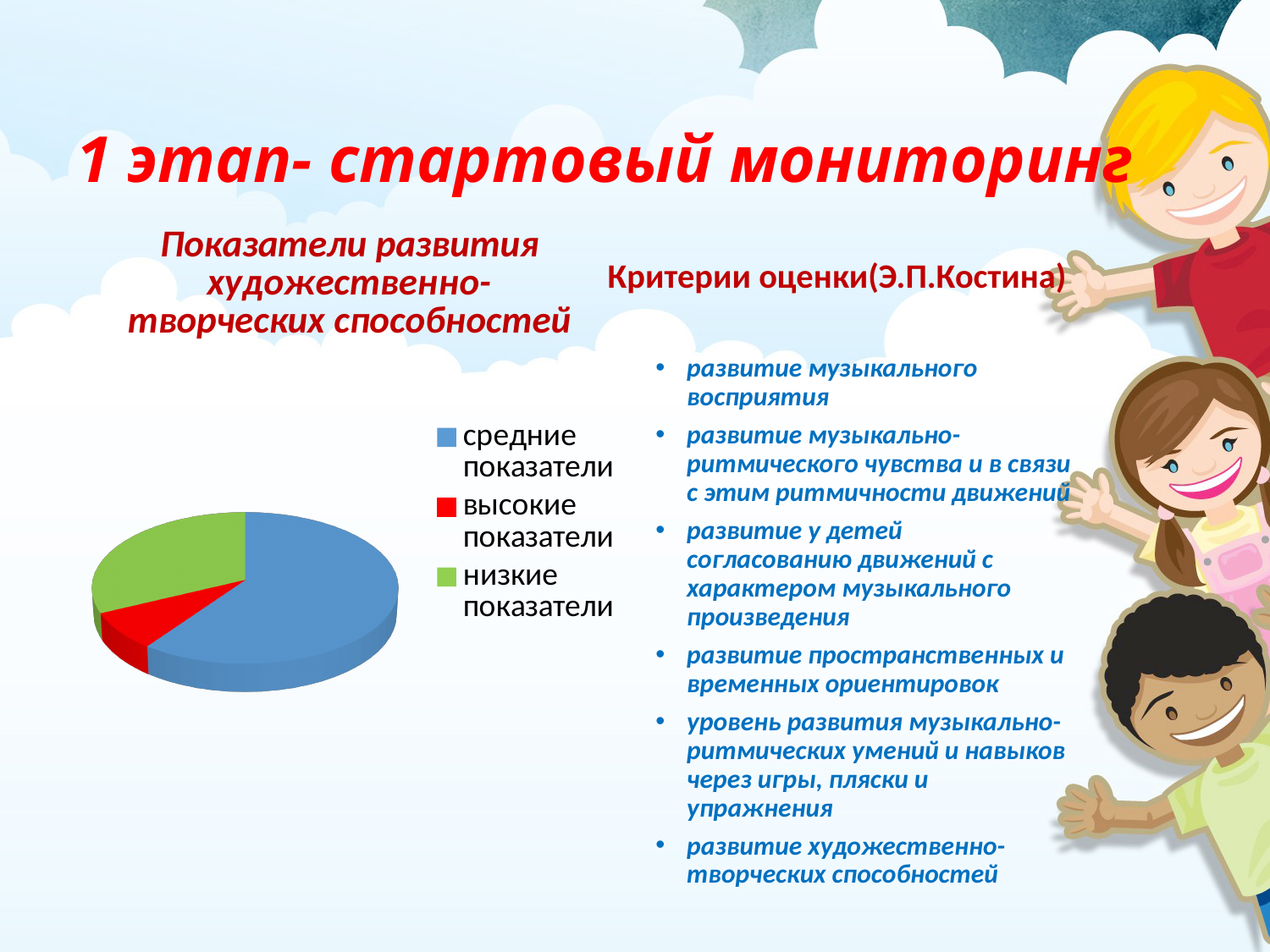
Which slice is larger in the pie chart: низкие показатели or высокие показатели? низкие показатели What colour is the slice for высокие показатели in the pie chart? red How many entries does the legend of the pie chart list? 3 Which slice is larger in the pie chart: средние показатели or низкие показатели? средние показатели Which category is shown in green in the pie chart? низкие показатели Which category takes the smallest share of the pie chart? высокие показатели What kind of chart is shown on the slide? pie chart How many slices does the pie chart have? 3 Which category takes the largest share of the pie chart? средние показатели